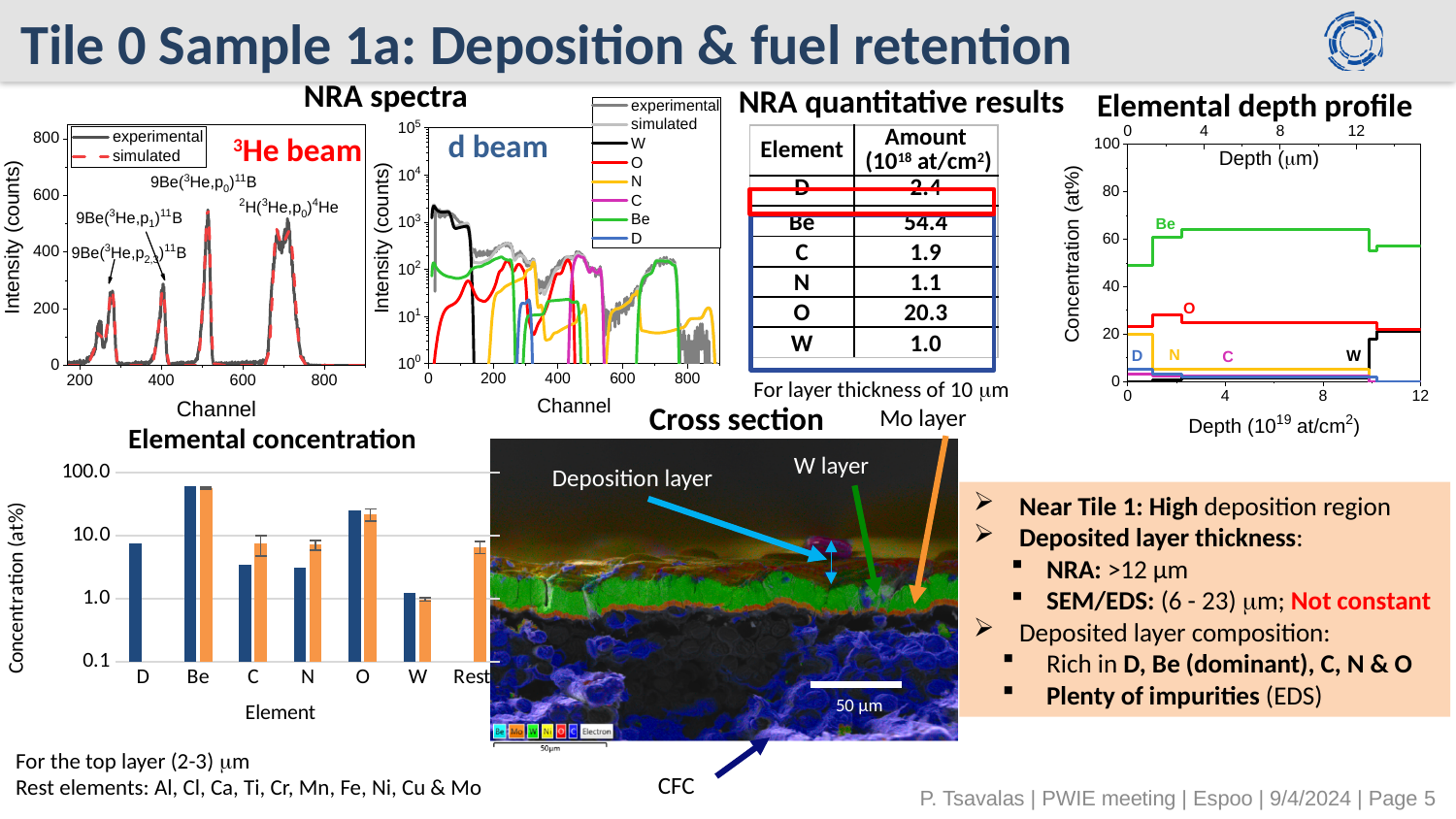
In the Elemental concentration chart, which element has the highest concentration? Be What kind of chart are the NRA spectra? line chart How many series does the legend of the 3He beam NRA spectrum list? 2 In the Elemental concentration chart, which element has the lowest concentration? W How many series does the legend of the d beam NRA spectrum list? 8 In the Elemental concentration chart, is the value for Be greater or less than 10.0? greater What kind of chart is the Elemental concentration chart? bar chart In the Elemental concentration chart, is the value for O greater or less than 10.0? greater In the Elemental depth profile chart, which element has the highest concentration? Be In the Elemental concentration chart, is the value for D greater or less than 10.0? less How many element categories are shown on the x axis of the Elemental concentration chart? 7